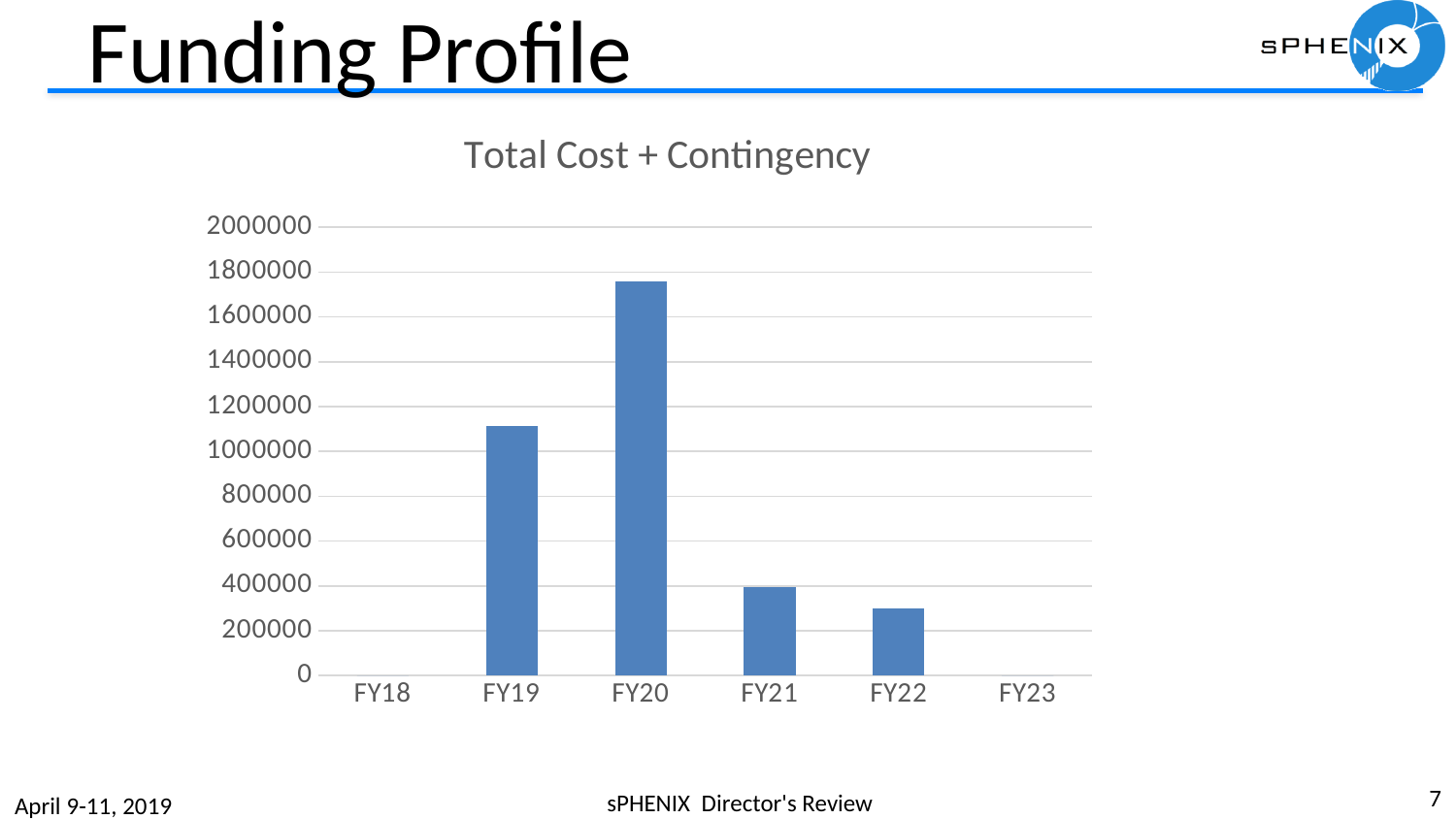
How many fiscal year categories are shown on the x axis? 6 What is the title of the chart? Total Cost + Contingency Which fiscal year has the highest Total Cost + Contingency? FY20 Is the value for FY19 greater or less than 1000000? greater Which is larger, the value for FY21 or the value for FY22? FY21 What is the highest value shown on the y axis? 2000000 Is the value for FY22 greater or less than 400000? less Is the value for FY20 greater or less than 1600000? greater What kind of chart is shown on the slide? bar chart Do the values rise or fall from FY20 to FY22? fall Which is larger, the value for FY19 or the value for FY20? FY20